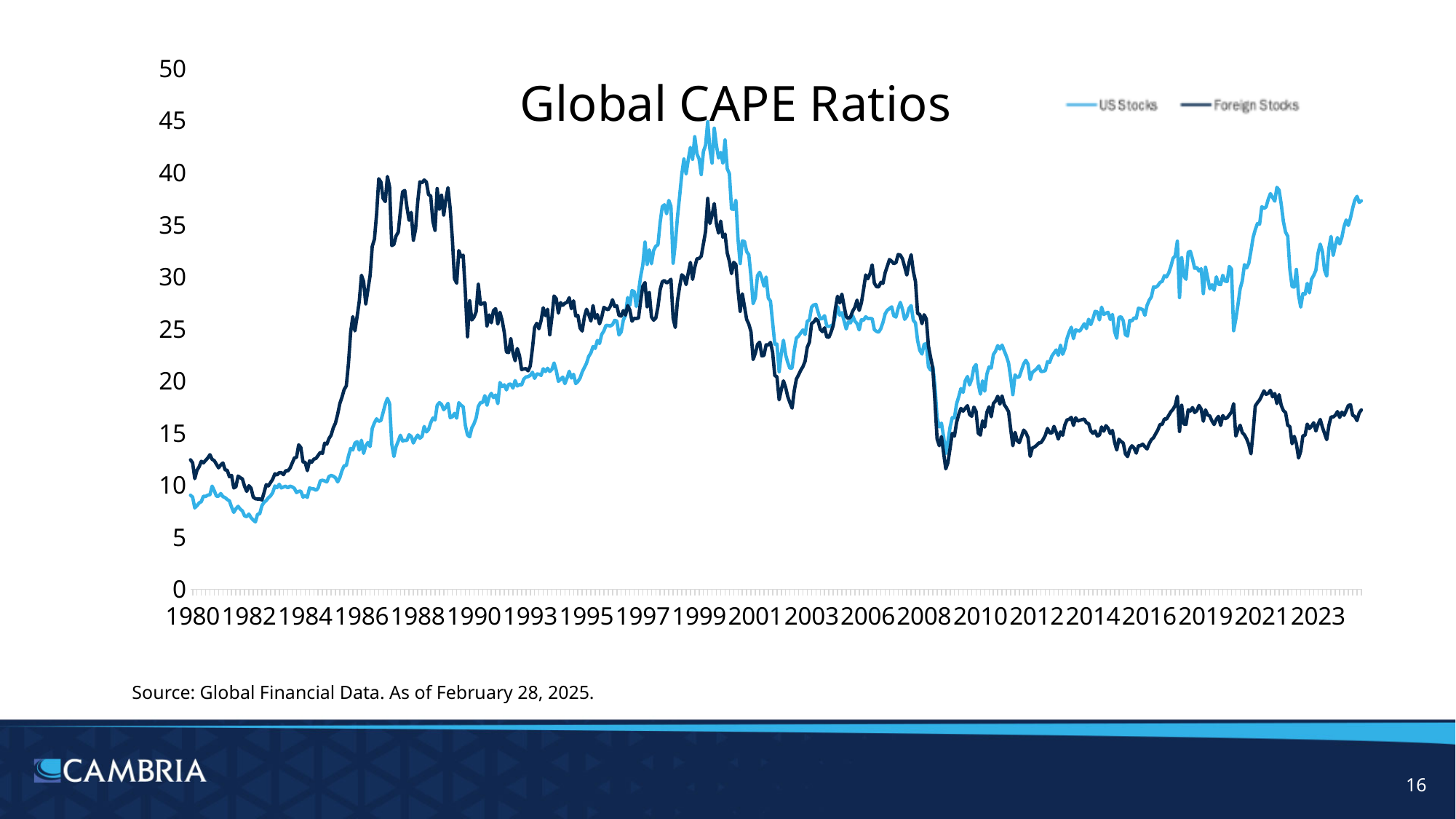
Is the peak value of Foreign Stocks around 1988 greater or less than 35? greater What is the title of the chart? Global CAPE Ratios Is the value for Foreign Stocks at the end of the chart (2023) greater or less than 20? less Does the US Stocks line generally rise or fall from 2009 to 2023? rise What kind of chart is shown on the slide? line chart Is the peak value of US Stocks around 1999 greater or less than 40? greater How many series does the legend list? 2 What are the two series named in the legend? US Stocks and Foreign Stocks At the end of the chart (2023), which series is higher, US Stocks or Foreign Stocks? US Stocks Around 1988, which series is higher, US Stocks or Foreign Stocks? Foreign Stocks